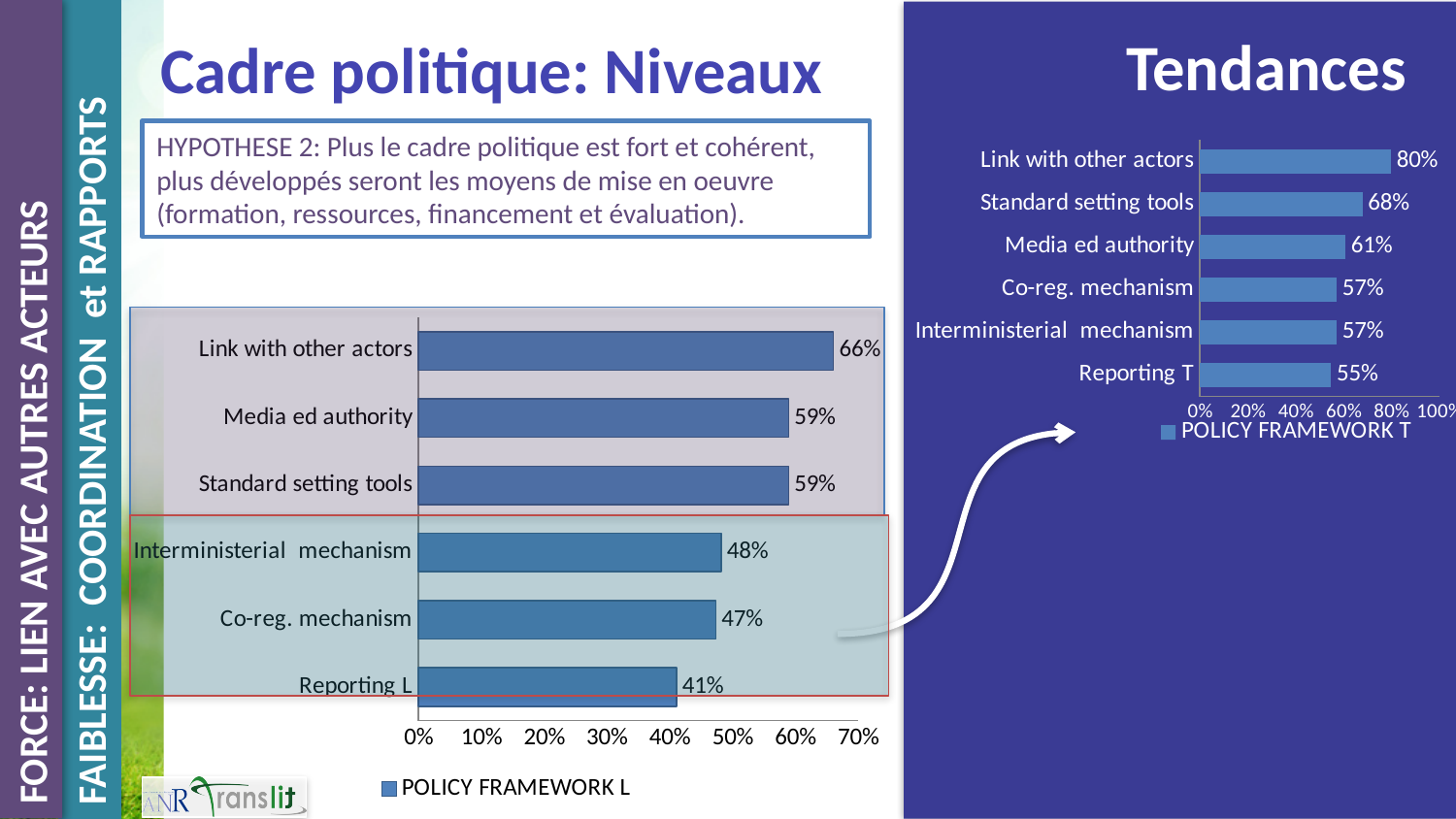
In the left chart (POLICY FRAMEWORK L), which category has the lowest value? Reporting L In the right chart under Tendances (POLICY FRAMEWORK T), which is larger: Media ed authority or Co-reg. mechanism? Media ed authority In the right chart under Tendances (POLICY FRAMEWORK T), which category has the highest value? Link with other actors In the right chart under Tendances (POLICY FRAMEWORK T), what is the difference between Link with other actors and Reporting T? 25% In the left chart (POLICY FRAMEWORK L), what is the value for Reporting L? 41% In the right chart under Tendances (POLICY FRAMEWORK T), what is the value for Standard setting tools? 68% What is the legend entry of the left chart? POLICY FRAMEWORK L What type of chart is the left chart (POLICY FRAMEWORK L)? Bar chart How many series does the legend of the right chart under Tendances list? 1 In the left chart (POLICY FRAMEWORK L), what is the difference between Link with other actors and Interministerial mechanism? 18% In the left chart (POLICY FRAMEWORK L), how many categories are plotted? 6 In the left chart (POLICY FRAMEWORK L), what is the value for Link with other actors? 66%